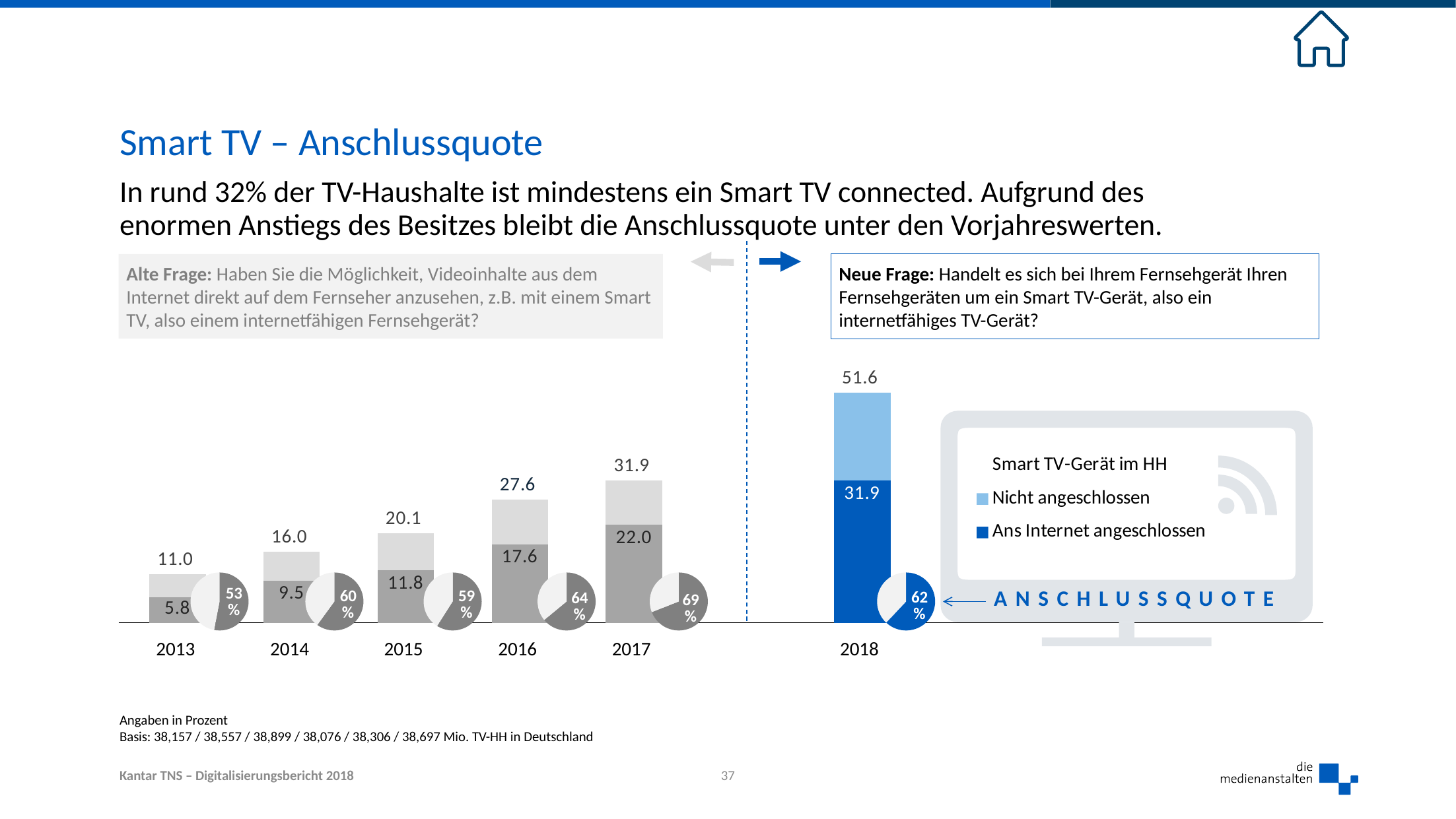
Which year has the highest Anschlussquote percentage in the pies? 2017 Is the 'Ans Internet angeschlossen' value larger in 2016 or in 2015? 2016 What is the total share of households with a Smart TV (top bar label) in 2018? 51.6 What Anschlussquote percentage is shown in the pie for 2016? 64% How many series does the legend 'Smart TV-Gerät im HH' list? 2 What is the value for 'Ans Internet angeschlossen' in 2017? 22.0 Do the total Smart TV values (top bar labels) rise or fall from 2013 to 2018? Rise What kind of chart shows the Smart TV values per year? Bar chart What is the value for 'Ans Internet angeschlossen' in 2013? 5.8 What is the difference between the total Smart TV share in 2018 (51.6) and in 2017 (31.9)? 19.7 How many years are shown on the x axis of the chart? 6 Which year has the lowest total Smart TV share (top bar label)? 2013